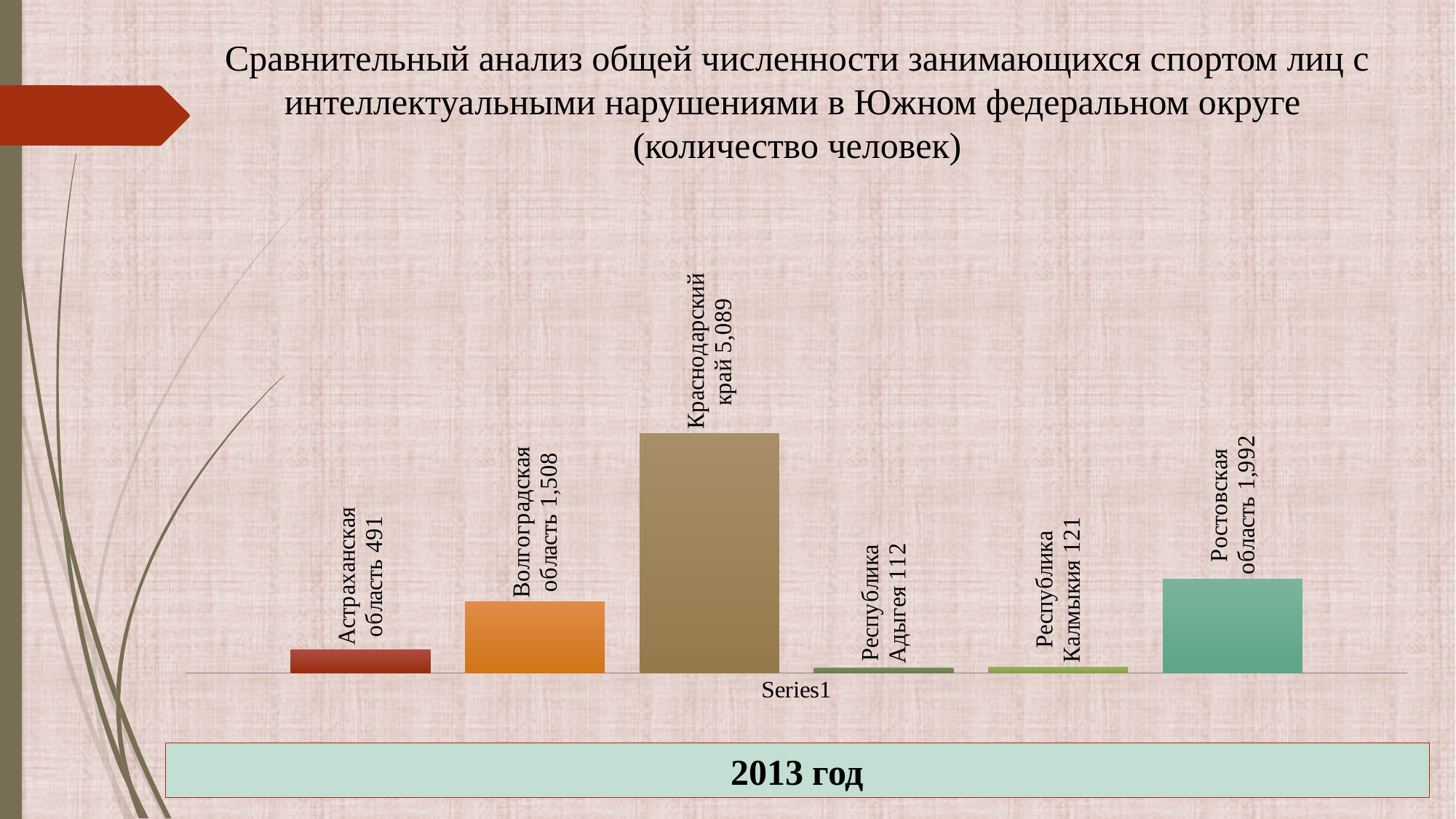
What is the value shown for Астраханская область? 491 What is the value shown for Республика Калмыкия? 121 What is the difference between the values for Республика Калмыкия and Республика Адыгея? 9 What year is indicated in the box below the chart? 2013 год What is the value shown for Ростовская область? 1,992 Which region has the lowest value in the chart? Республика Адыгея What kind of chart is shown on the slide? bar chart Which is larger: the value for Волгоградская область or the value for Ростовская область? Ростовская область How many bars (regions) are plotted in the chart? 6 What is the value shown for Краснодарский край? 5,089 What is the difference between the values for Ростовская область and Волгоградская область? 484 Which region has the highest value in the chart? Краснодарский край